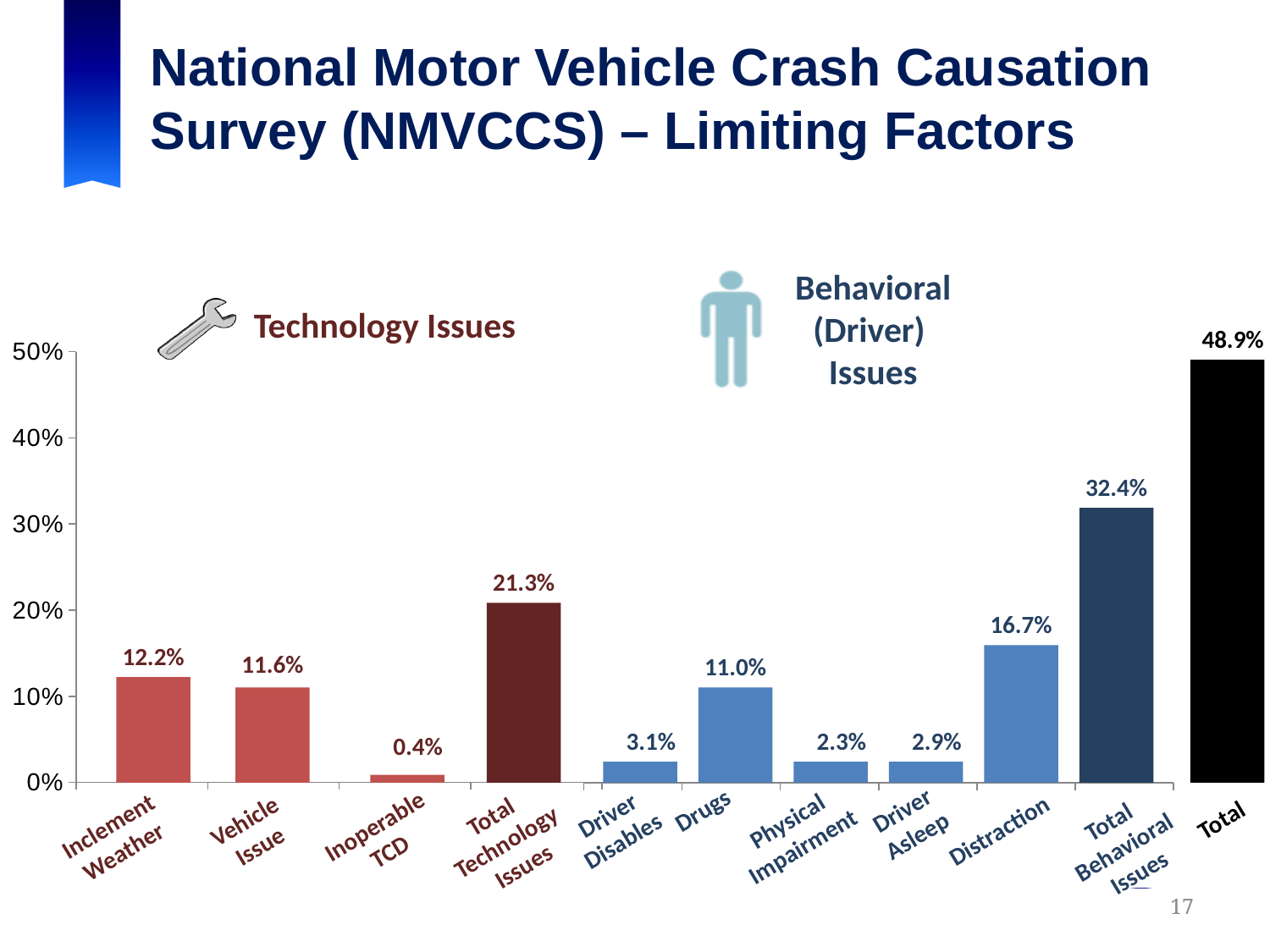
What is the value for Inoperable TCD? 0.4% Which category has the highest value? Total Which is larger, Drugs or Vehicle Issue? Vehicle Issue What colour is the Total bar? Black What is the value for Inclement Weather? 12.2% Which category has the lowest value? Inoperable TCD What is the difference between Total Behavioral Issues and Total Technology Issues? 11.1% What is the value for Distraction? 16.7% Is the value for Total Behavioral Issues greater or less than 30%? greater What kind of chart is shown on the slide? Bar chart What is the value for Total Technology Issues? 21.3% How many bars are shown in the chart? 11